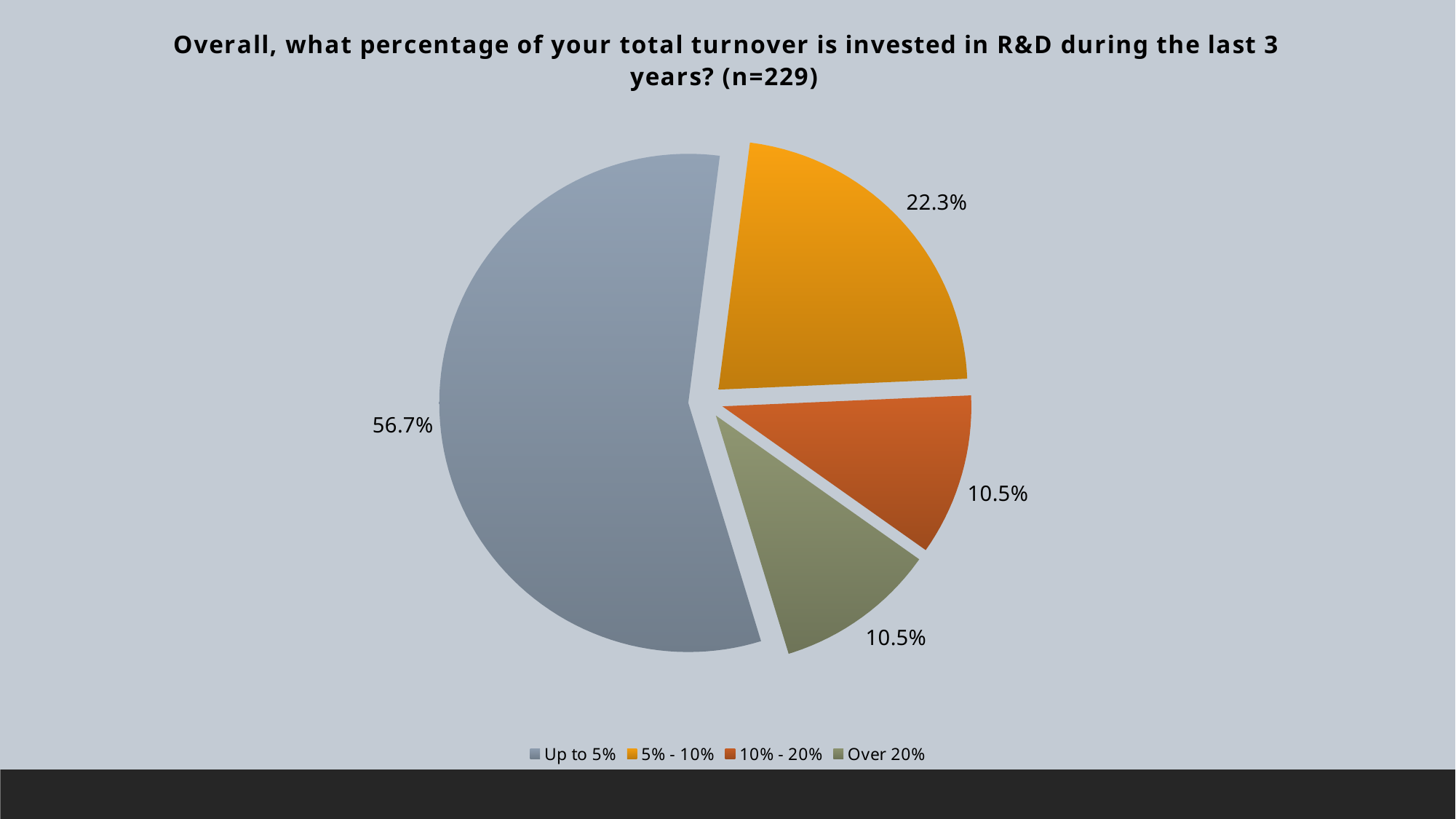
What share of respondents invest up to 5% of turnover in R&D? 56.7% What share of respondents invest 10% - 20% of turnover in R&D? 10.5% What share of respondents invest 5% - 10% of turnover in R&D? 22.3% Which is larger, the share for '5% - 10%' or the share for '10% - 20%'? 5% - 10% Which category has the largest share of the pie? Up to 5% How many respondents (n) does the chart title state? 229 What is the combined share of the '10% - 20%' and 'Over 20%' categories? 21.0% How many categories does the legend list? 4 What type of chart is shown on the slide? Pie chart What share of respondents invest over 20% of turnover in R&D? 10.5% What is the difference between the shares for 'Up to 5%' and '5% - 10%'? 34.4% What colour is the slice for 'Up to 5%'? Grey